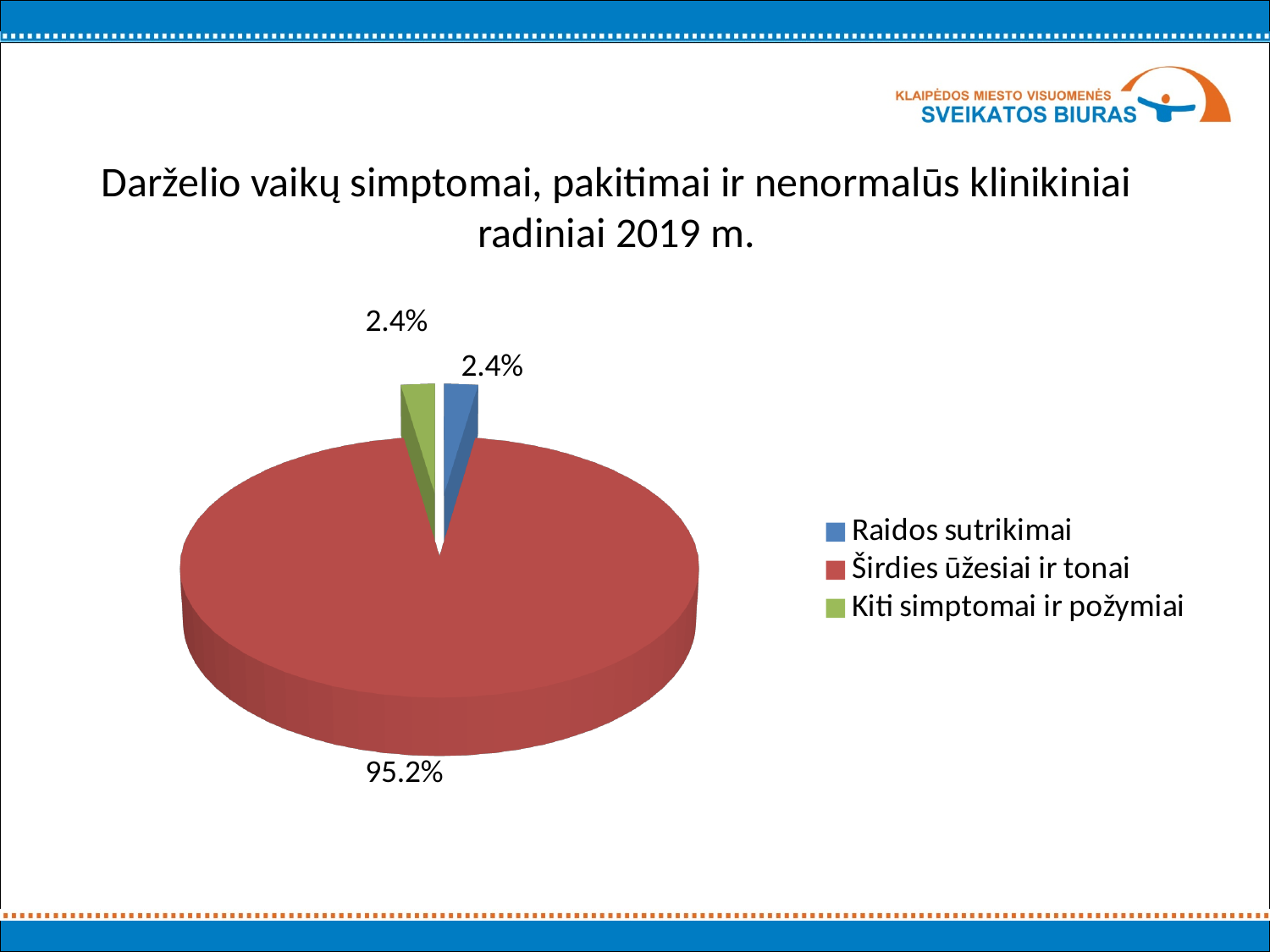
What kind of chart is shown on the slide? Pie chart How many slices does the pie chart have? 3 How many entries does the legend list? 3 What share of the pie does Raidos sutrikimai represent? 2.4% What share of the pie does Širdies ūžesiai ir tonai represent? 95.2% What year is referred to in the chart title? 2019 Which is larger, the share for Širdies ūžesiai ir tonai or the share for Kiti simptomai ir požymiai? Širdies ūžesiai ir tonai Is the share for Širdies ūžesiai ir tonai greater or less than 50%? greater Which colour represents Kiti simptomai ir požymiai in the pie chart? Green Which category has the largest slice of the pie? Širdies ūžesiai ir tonai What is the difference in percentage points between Širdies ūžesiai ir tonai and Raidos sutrikimai? 92.8 What share of the pie does Kiti simptomai ir požymiai represent? 2.4%